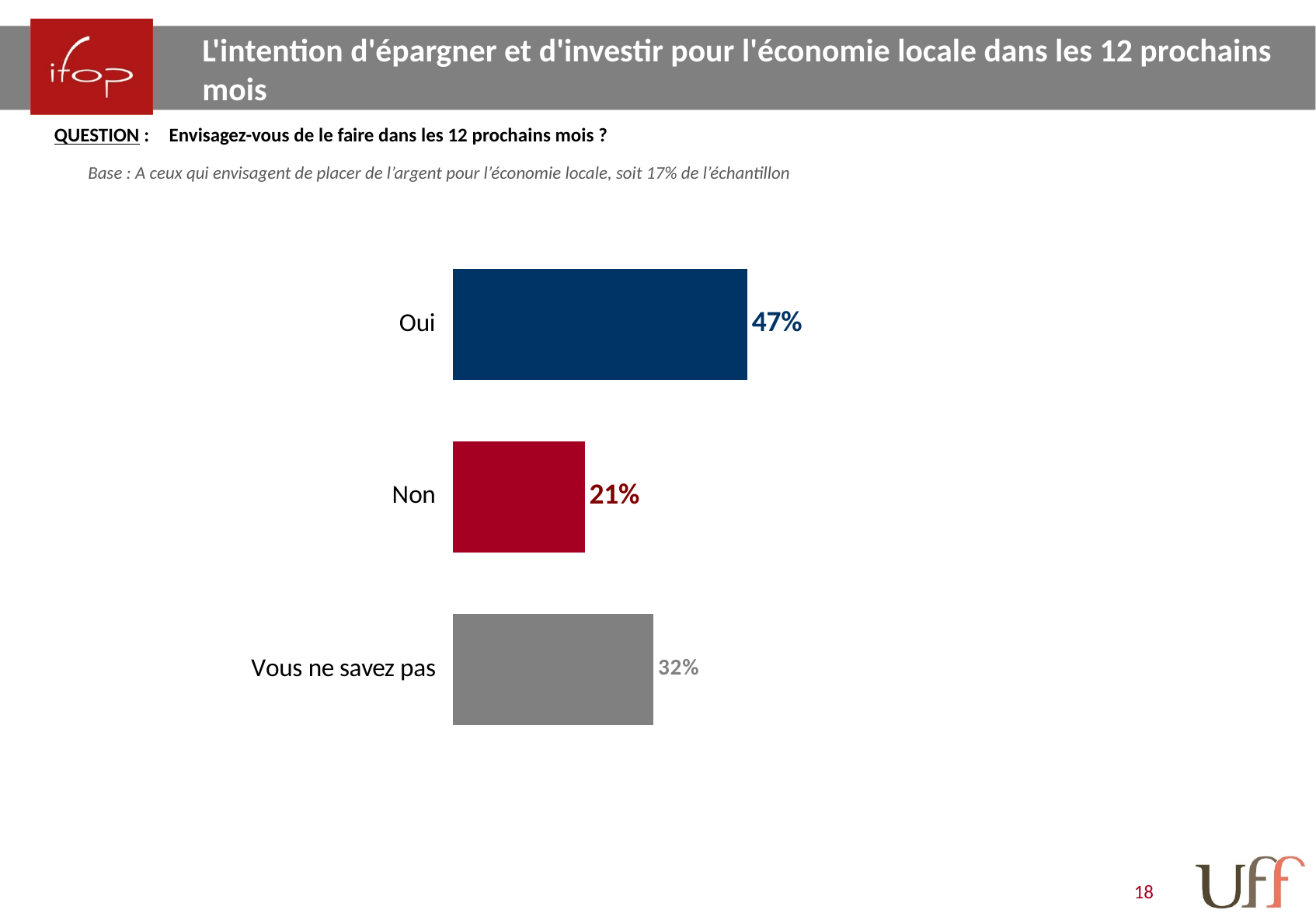
What is the value for "Oui"? 47% Which category has the lowest value? Non How many categories are shown in the chart? 3 Which category has the highest value? Oui What kind of chart is shown on the slide? Bar chart What colour is the bar for "Non"? Red What is the difference between the values for "Oui" and "Non"? 26% What colour is the bar for "Oui"? Dark blue What is the difference between the values for "Vous ne savez pas" and "Non"? 11% What is the value for "Non"? 21% What is the value for "Vous ne savez pas"? 32% Which is larger, the value for "Oui" or the value for "Vous ne savez pas"? Oui